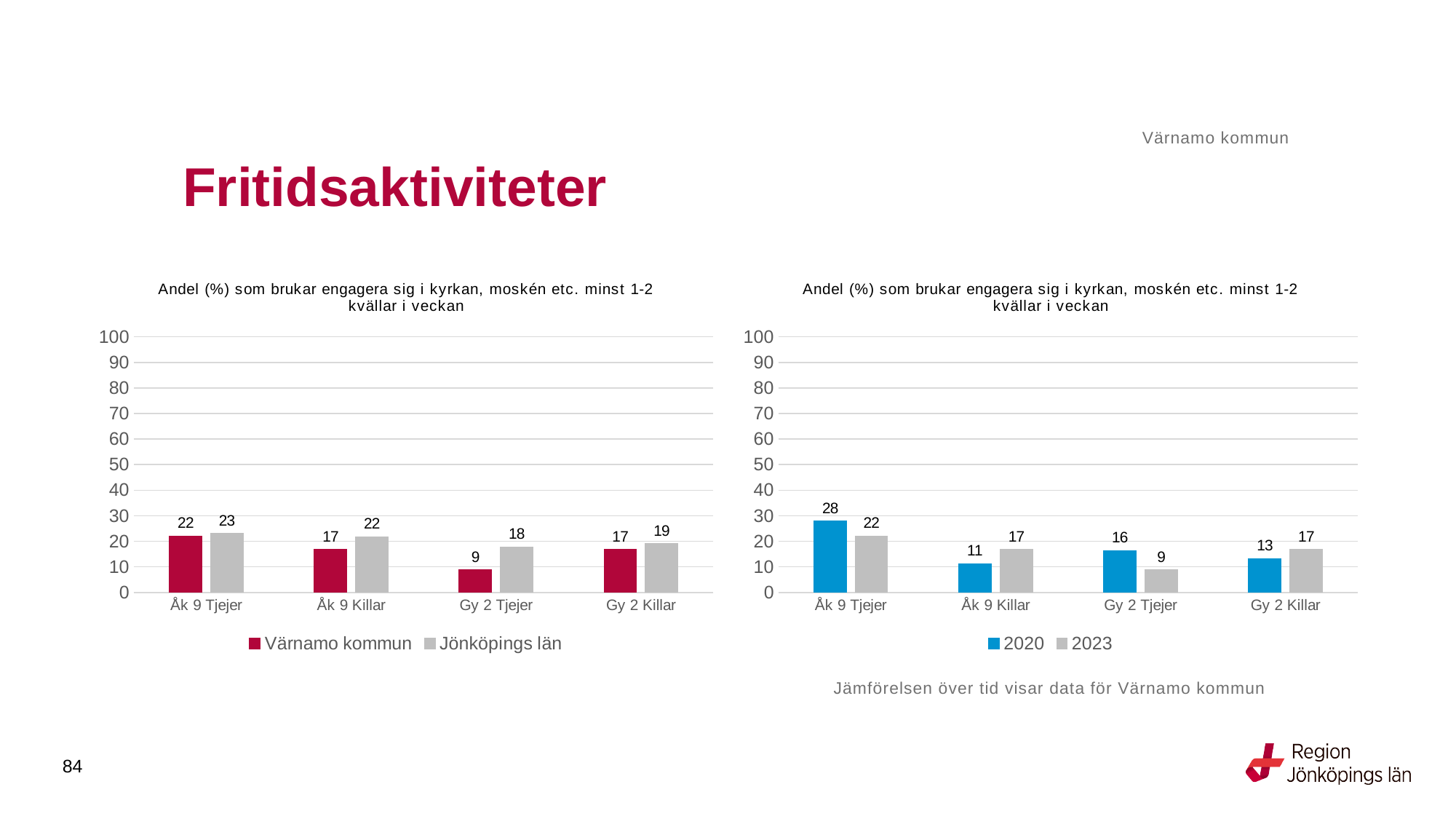
In the left chart, what is the value for Jönköpings län for Gy 2 Tjejer? 18 In the left chart, what is the difference between Jönköpings län and Värnamo kommun for Gy 2 Tjejer? 9 In the right chart, how many categories are shown on the x axis? 4 In the left chart, how many series does the legend list? 2 In the right chart, what is the value for 2023 for Gy 2 Killar? 17 In the right chart, what is the difference between 2020 and 2023 for Åk 9 Killar? 6 In the right chart, which category has the highest value for 2020? Åk 9 Tjejer In the left chart, which category has the lowest value for Värnamo kommun? Gy 2 Tjejer In the left chart, what is the value for Värnamo kommun for Åk 9 Tjejer? 22 In the right chart, what is the value for 2020 for Åk 9 Tjejer? 28 In the right chart, which is larger for Gy 2 Tjejer, 2020 or 2023? 2020 What kind of chart is the left chart? Bar chart